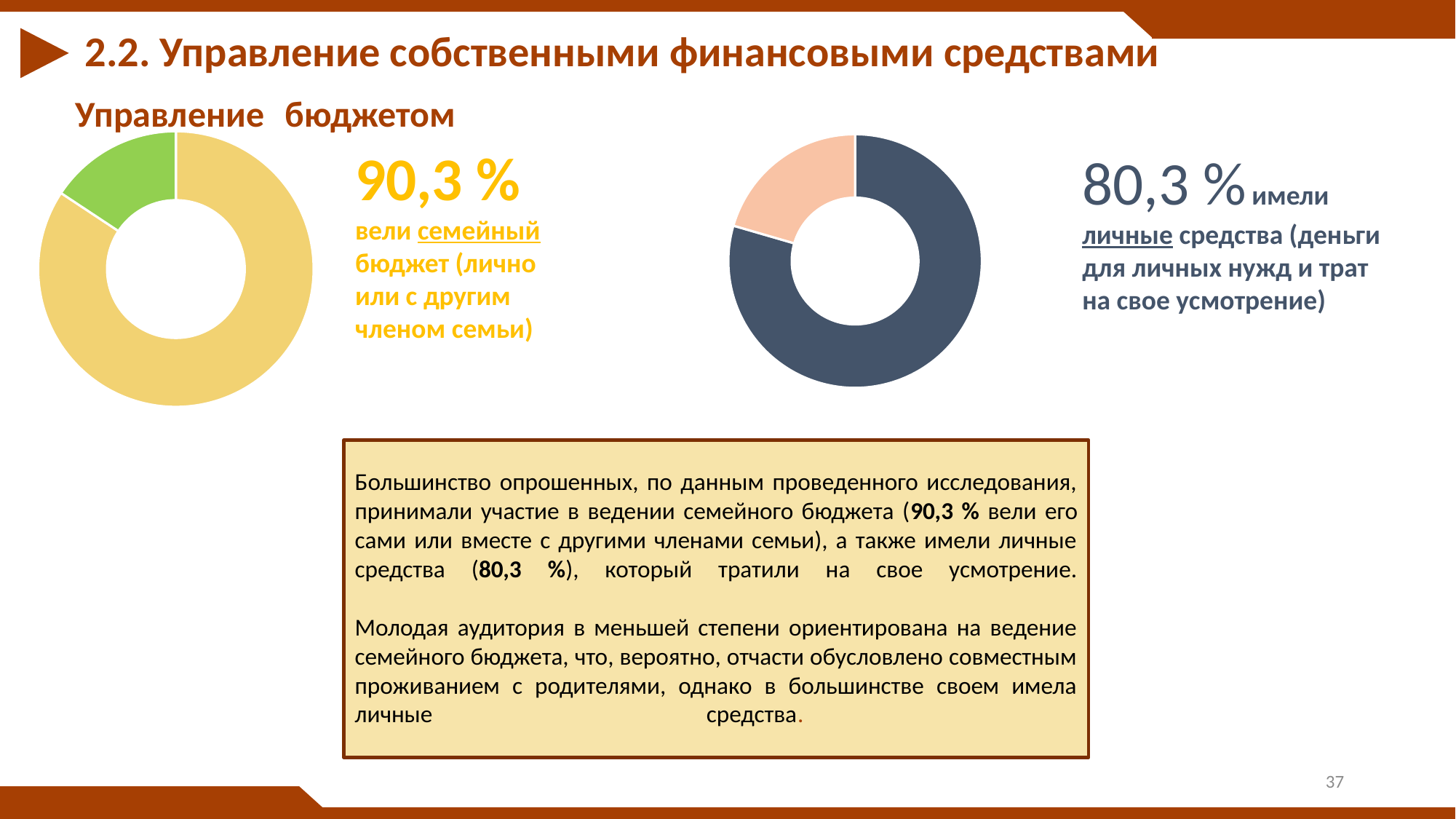
Which is larger: the share that managed a family budget (left chart) or the share that had personal funds (right chart)? The share that managed a family budget (90,3 %) What is the difference between the share that managed a family budget (90,3 %) and the share that had personal funds (80,3 %)? 10 percentage points In the left chart, which slice is larger: the yellow one or the green one? The yellow one What kind of chart is the right chart on the slide? Donut (pie) chart What colour is the slice representing 90,3 % in the left chart? Yellow In the right chart, which slice is larger: the dark blue-grey one or the peach one? The dark blue-grey one How many slices does the right donut chart have? 2 How many slices does the left donut chart have? 2 In the left chart, what share of respondents managed a family budget (вели семейный бюджет)? 90,3 % What colour is the slice representing 80,3 % in the right chart? Dark blue-grey In the right chart, what share of respondents had personal funds (имели личные средства)? 80,3 % What kind of chart is the left chart under "Управление бюджетом"? Donut (pie) chart